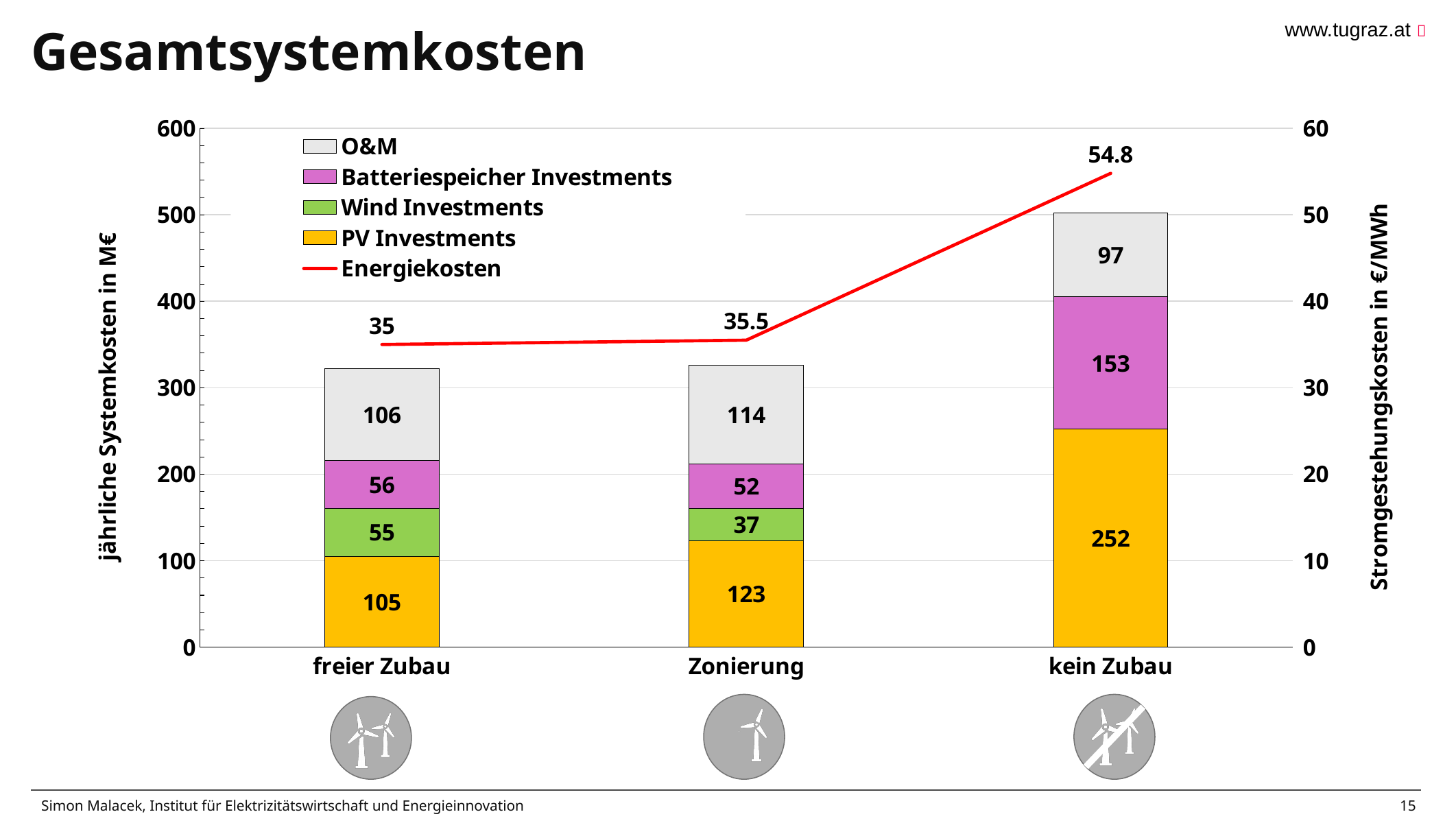
Which category has the lowest Energiekosten value? freier Zubau Does the Energiekosten line rise or fall from freier Zubau to kein Zubau? rise How many series does the legend list? 5 What is the difference between the PV Investments values for kein Zubau and Zonierung? 129 Which is larger, the O&M value for Zonierung or for kein Zubau? Zonierung How many categories are shown on the x axis? 3 What is the O&M value for freier Zubau? 106 What is the Wind Investments value for Zonierung? 37 What is the value of PV Investments for kein Zubau? 252 What is the Energiekosten value for Zonierung? 35.5 Which category has the highest Batteriespeicher Investments value? kein Zubau What is the total of the stacked bar for kein Zubau? 502